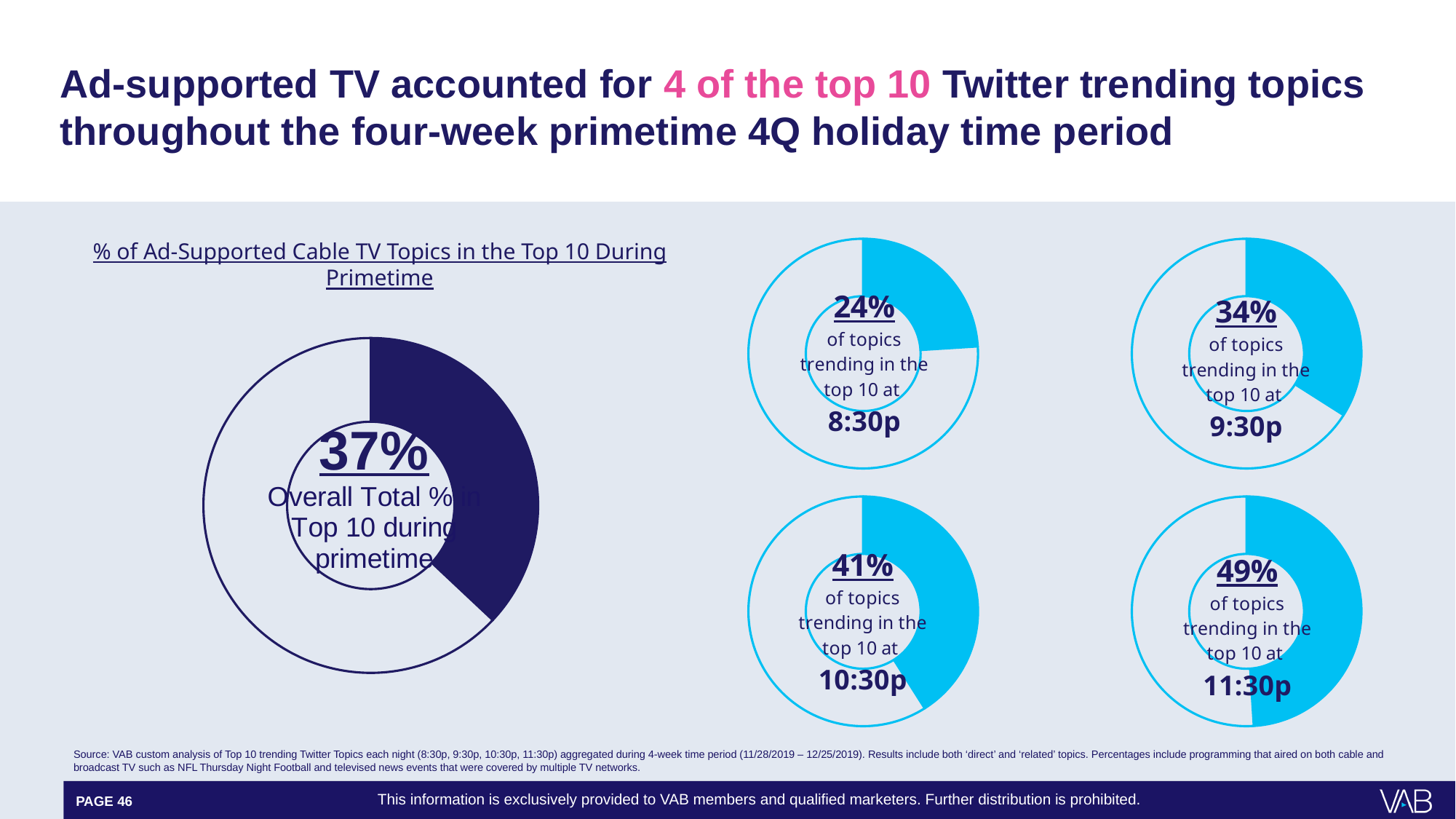
On the small donut chart for 10:30p, what percentage of topics were trending in the top 10? 41% On the small donut chart for 11:30p, what percentage of topics were trending in the top 10? 49% On the large donut chart titled '% of Ad-Supported Cable TV Topics in the Top 10 During Primetime', what is the overall total percentage in the top 10 during primetime? 37% How many small time-slot donut charts are shown on the right side of the slide? 4 On the small donut chart for 9:30p, what percentage of topics were trending in the top 10? 34% What is the difference between the percentage shown on the 11:30p donut chart and the percentage shown on the 8:30p donut chart? 25% Across the four small donut charts, do the percentages rise or fall as the time slot gets later (from 8:30p to 11:30p)? rise Which is larger: the percentage on the 9:30p donut chart or the percentage on the 10:30p donut chart? 10:30p What type of chart is used to show the 37% overall total on the left of the slide? donut (pie) chart On the small donut chart for 8:30p, what percentage of topics were trending in the top 10? 24% Among the four small time-slot donut charts, which time slot has the highest percentage of topics trending in the top 10? 11:30p Among the four small time-slot donut charts, which time slot has the lowest percentage of topics trending in the top 10? 8:30p